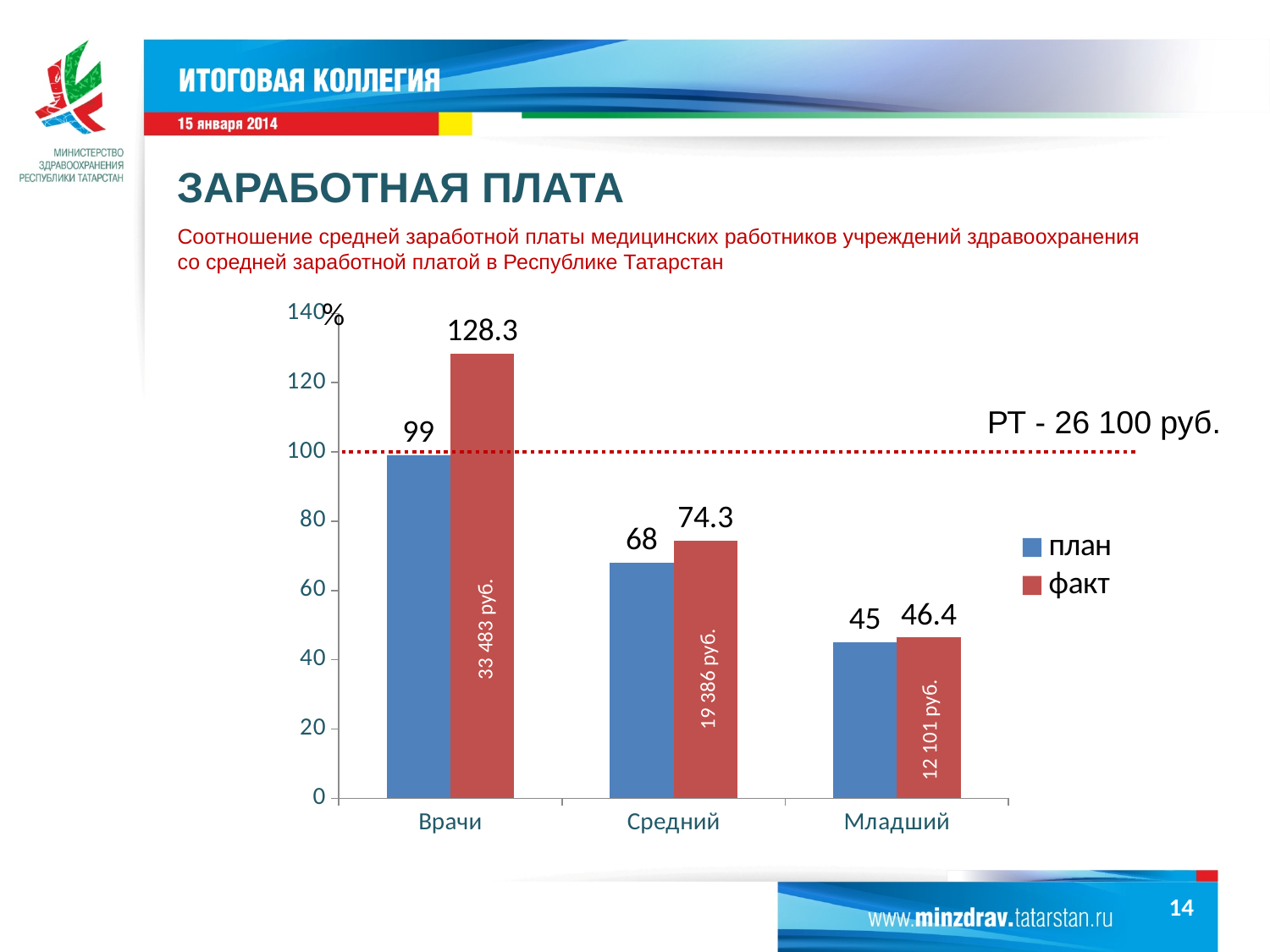
What type of chart is shown on the slide? bar chart What is the факт value for Младший? 46.4 Is the факт value for Врачи greater or less than 120? greater What is the difference between the факт values for Средний and Младший? 27.9 Which category has the lowest план value? Младший Which is larger for Средний, the план value or the факт value? факт What is the план value for Средний? 68 What is the difference between the факт and план values for Врачи? 29.3 Which category has the highest факт value? Врачи How many series does the legend list? 2 How many categories are shown on the x axis? 3 What is the факт value for Врачи? 128.3